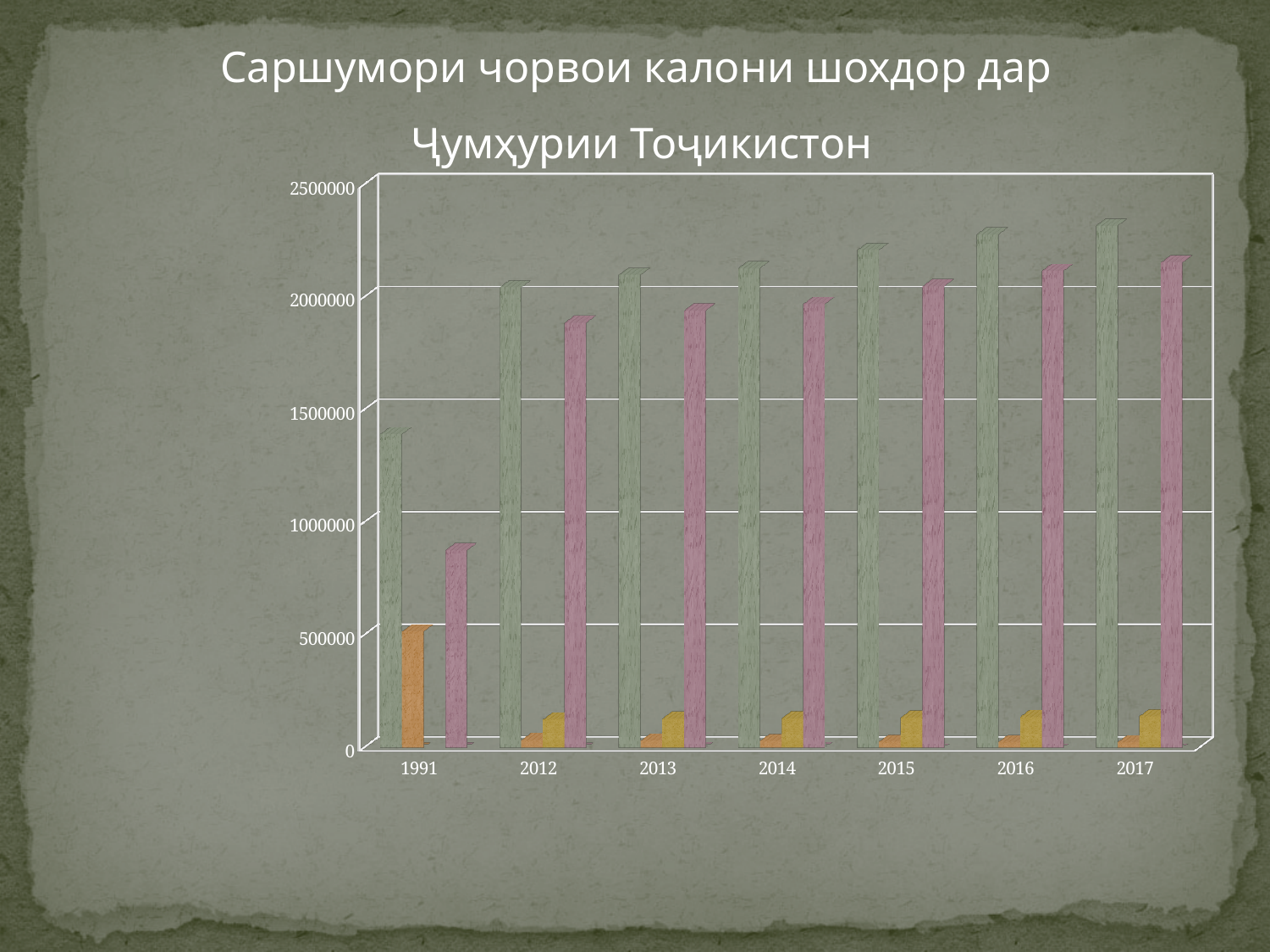
In 2017, which is larger: the green bar or the pink bar? the green bar Which year has the shortest pink bar? 1991 What is the title of the chart? Саршумори чорвои калони шохдор дар Ҷумҳурии Тоҷикистон How many bars are shown for each year in the chart? 4 How many years are shown on the x axis of the chart? 7 Is the value of the green bar for 1991 greater or less than 1500000? less Which year has the shortest green bar? 1991 Do the green bars rise or fall from 2012 to 2017? rise Is the value of the pink bar for 1991 greater or less than 1000000? less What kind of chart is shown on the slide? bar chart Which year has the tallest green bar? 2017 Is the value of the green bar for 2017 greater or less than 2000000? greater